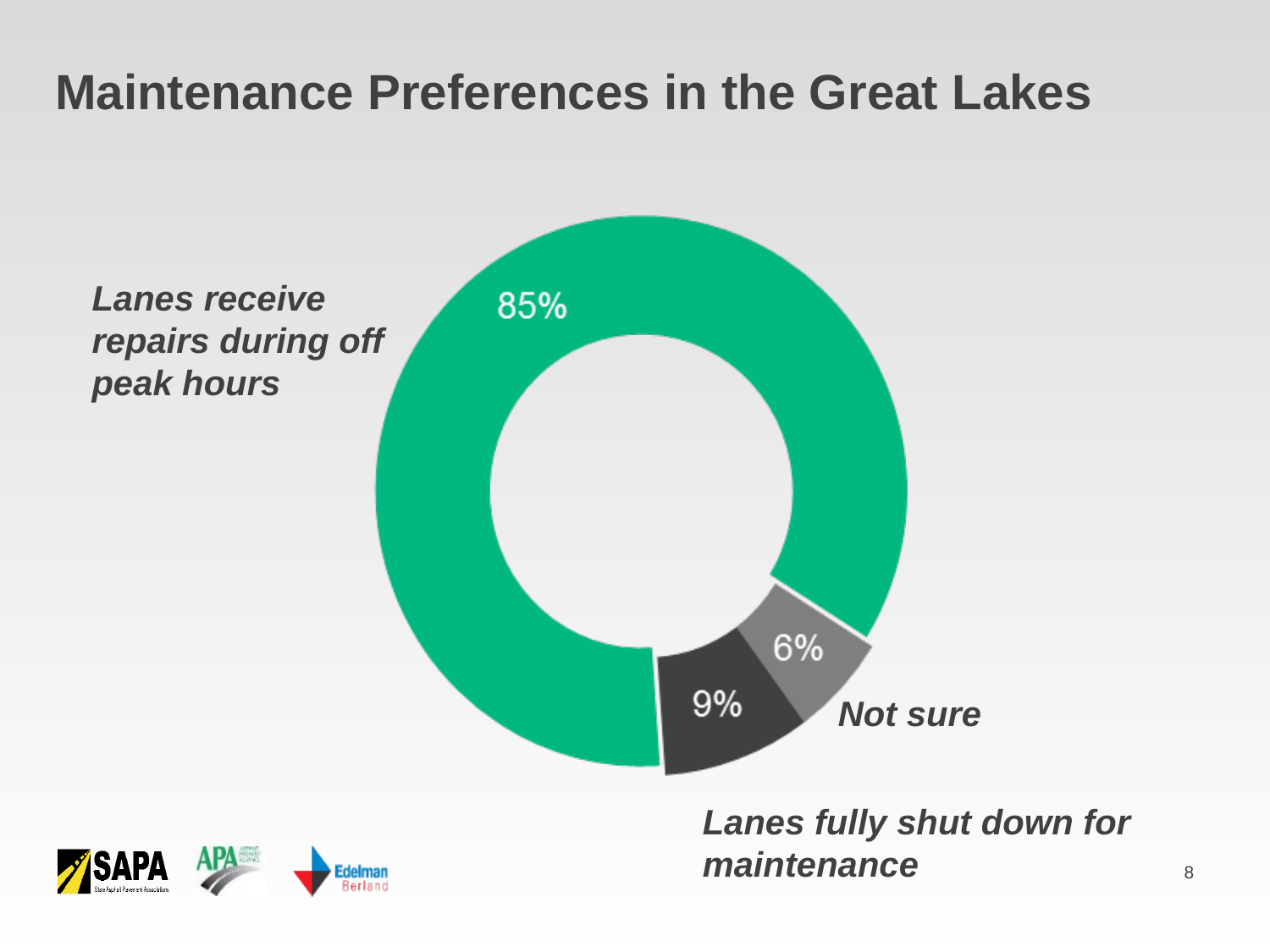
What is the title of the slide containing the chart? Maintenance Preferences in the Great Lakes What percentage of respondents prefer that lanes receive repairs during off peak hours? 85% What is the difference in percentage points between 'Lanes fully shut down for maintenance' and 'Not sure'? 3 percentage points Which response has the smallest share of the chart? Not sure What percentage of respondents answered 'Not sure'? 6% What is the difference in percentage points between 'Lanes receive repairs during off peak hours' and 'Lanes fully shut down for maintenance'? 76 percentage points What kind of chart is shown on the slide? Donut (pie) chart Which is larger: the share for 'Lanes fully shut down for maintenance' or the share for 'Not sure'? Lanes fully shut down for maintenance What percentage of respondents prefer that lanes be fully shut down for maintenance? 9% How many categories are shown in the chart? 3 Which maintenance preference has the largest share of the chart? Lanes receive repairs during off peak hours What colour is the slice for 'Lanes receive repairs during off peak hours'? Green